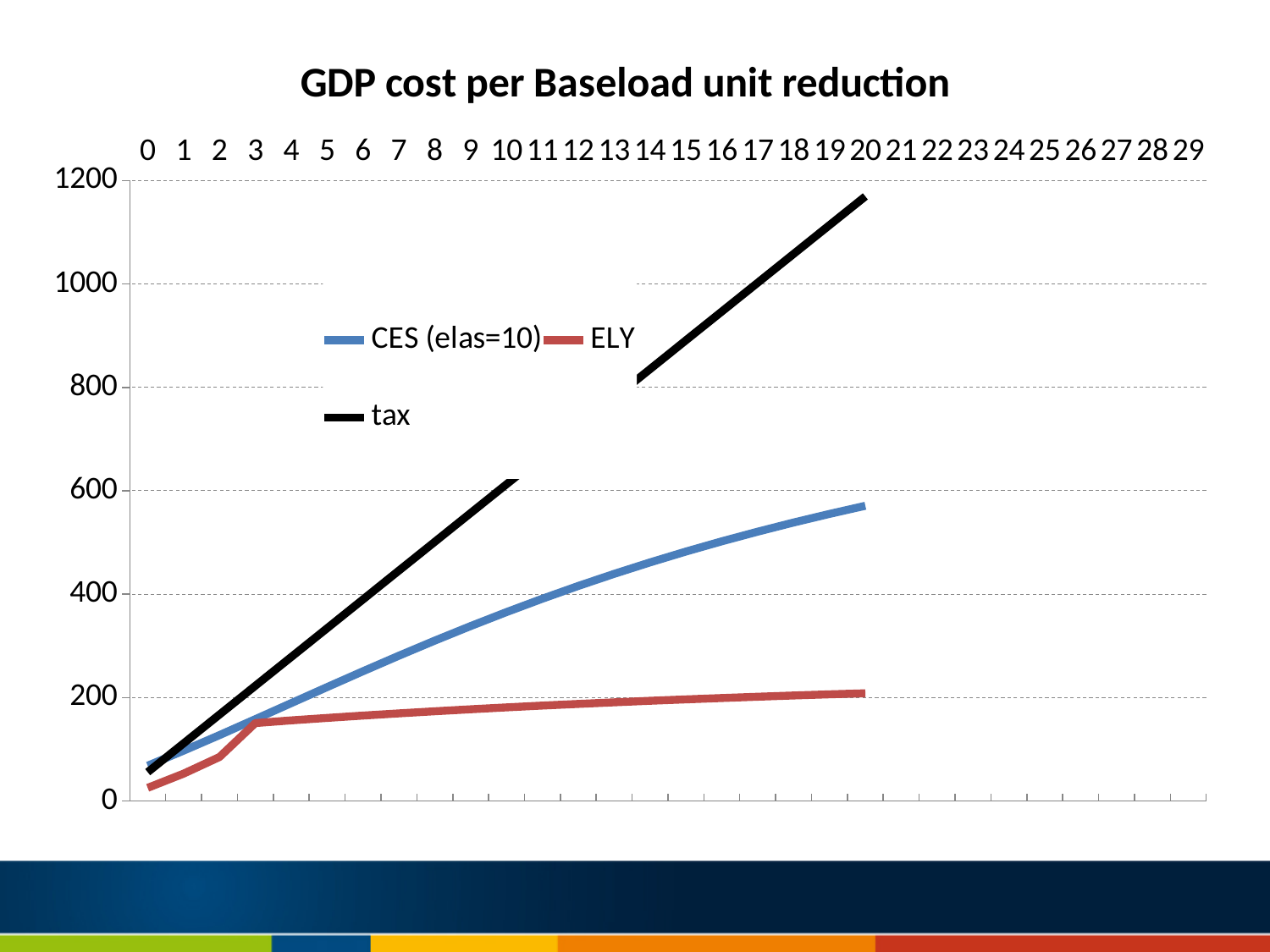
Which series has the highest value at x = 20? tax Is the value of the CES (elas=10) series at x = 20 greater or less than 600? less What is the title of the chart? GDP cost per Baseload unit reduction Is the value of the ELY series at x = 20 greater or less than 400? less Is the value of the tax series at x = 20 greater or less than 1000? greater Which series is drawn in black? tax Which series has the lowest value at x = 20? ELY At x = 20, which is larger: the CES (elas=10) series or the ELY series? CES (elas=10) What kind of chart is shown on the slide? line chart How many series does the legend list? 3 Does the CES (elas=10) series rise or fall as x increases from 0 to 20? rise